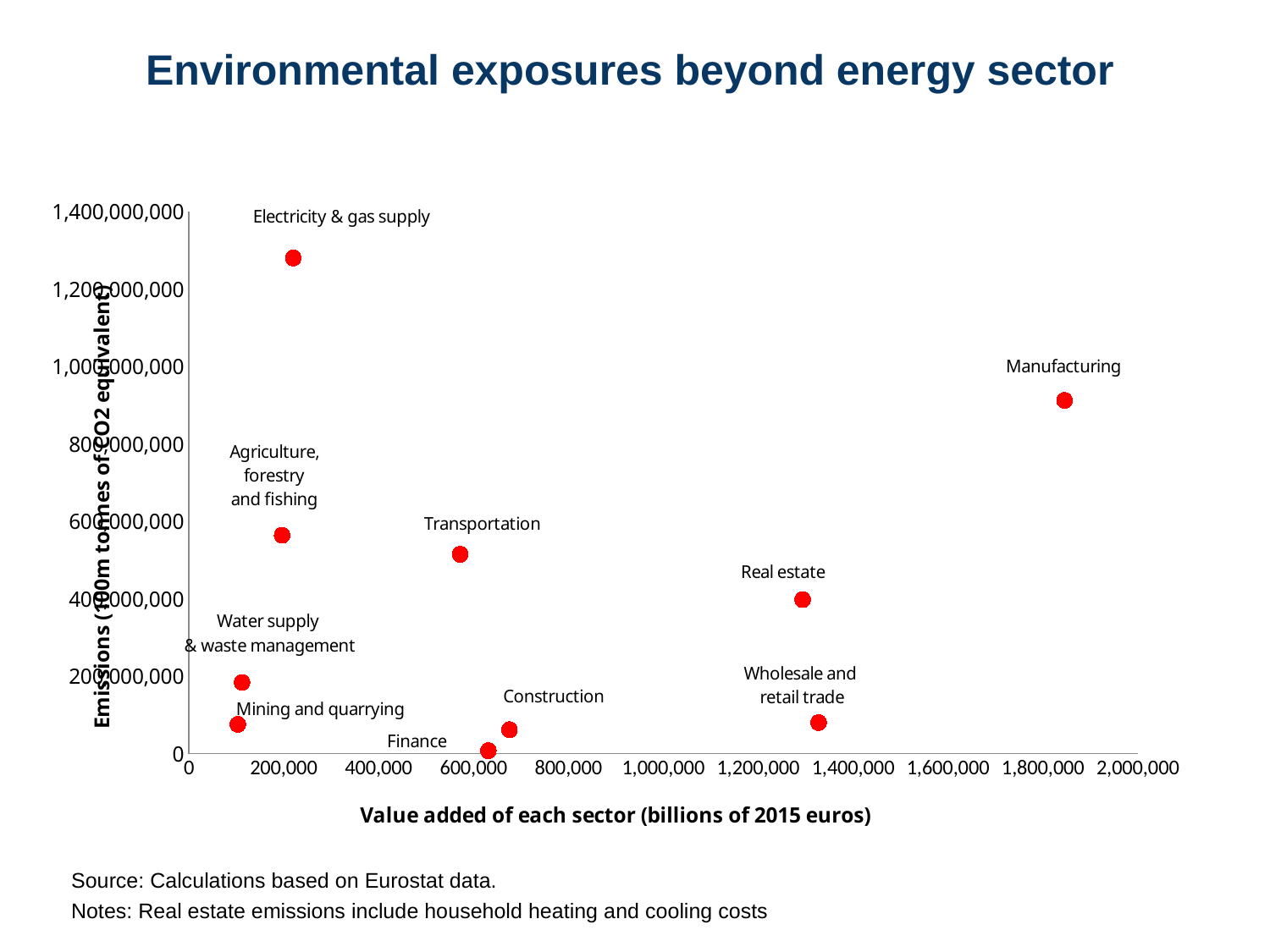
Are the emissions for Electricity & gas supply greater or less than 1,200,000,000? greater Which sector has the highest value added on the chart? Manufacturing Are the emissions for Manufacturing greater or less than 1,000,000,000? less What kind of chart is shown on the slide? Scatter chart Which sector has a higher value added, Real estate or Transportation? Real estate Is the value added for Real estate greater or less than 1,000,000? greater What is the title of the horizontal axis of the chart? Value added of each sector (billions of 2015 euros) Which sector has higher emissions, Transportation or Real estate? Transportation Which sector has the highest emissions on the chart? Electricity & gas supply How many sectors are plotted as points on the chart? 10 Which sector has the lowest emissions on the chart? Finance